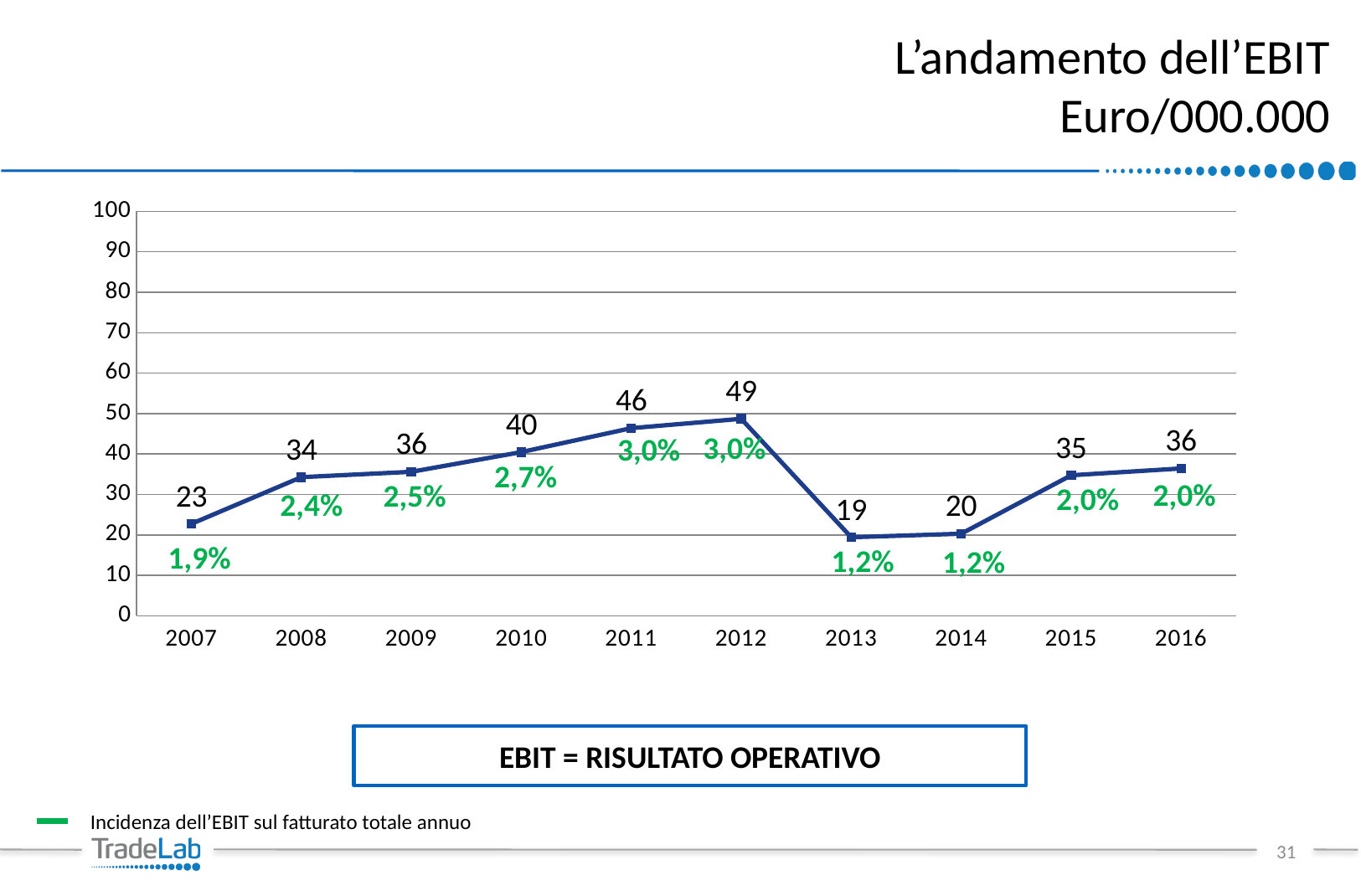
Which year has the larger EBIT value, 2008 or 2015? 2015 How many years are shown on the x axis? 10 What kind of chart is shown on the slide? line chart Which year has the highest EBIT value? 2012 What is the EBIT value for 2007? 23 What is the title of the chart? L'andamento dell'EBIT Euro/000.000 What is the difference between the EBIT values for 2012 and 2013? 30 Do the EBIT values rise or fall from 2007 to 2012? rise What is the EBIT value for 2012? 49 Is the EBIT value for 2011 greater or less than 40? greater What percentage incidence of EBIT on total annual revenue is shown for 2010? 2,7% Which year has the lowest EBIT value? 2013